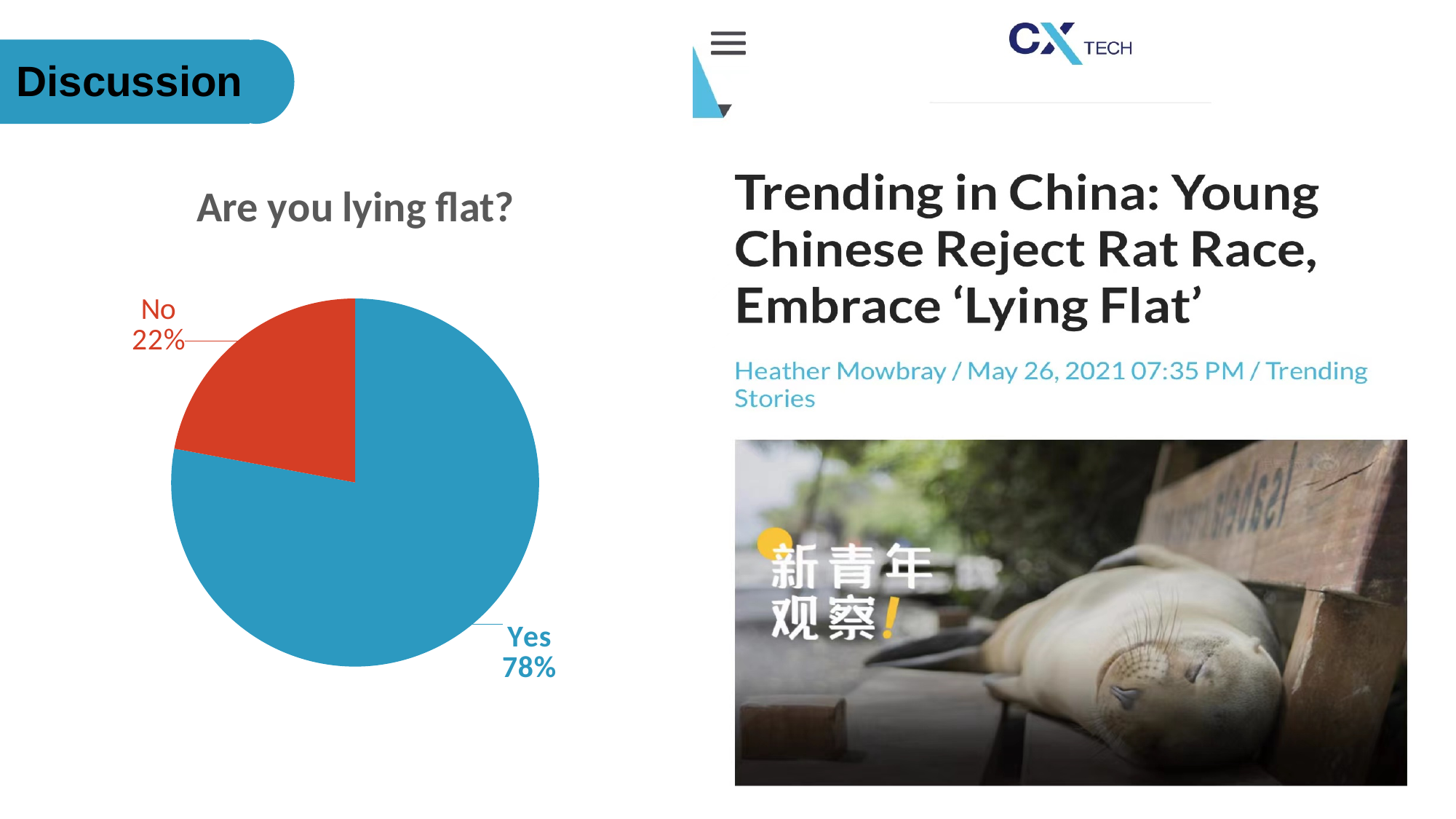
What is the title of the pie chart? Are you lying flat? Which response has the largest share of the pie? Yes What percentage of respondents answered Yes? 78% Which response has the smallest share of the pie? No Which slice is larger, Yes or No? Yes What is the difference in percentage points between the Yes and No slices? 56 Is the share for No greater or less than 50%? less How many slices does the pie chart have? 2 What kind of chart is shown on the slide? pie chart What colour is the Yes slice? blue What percentage of respondents answered No? 22%